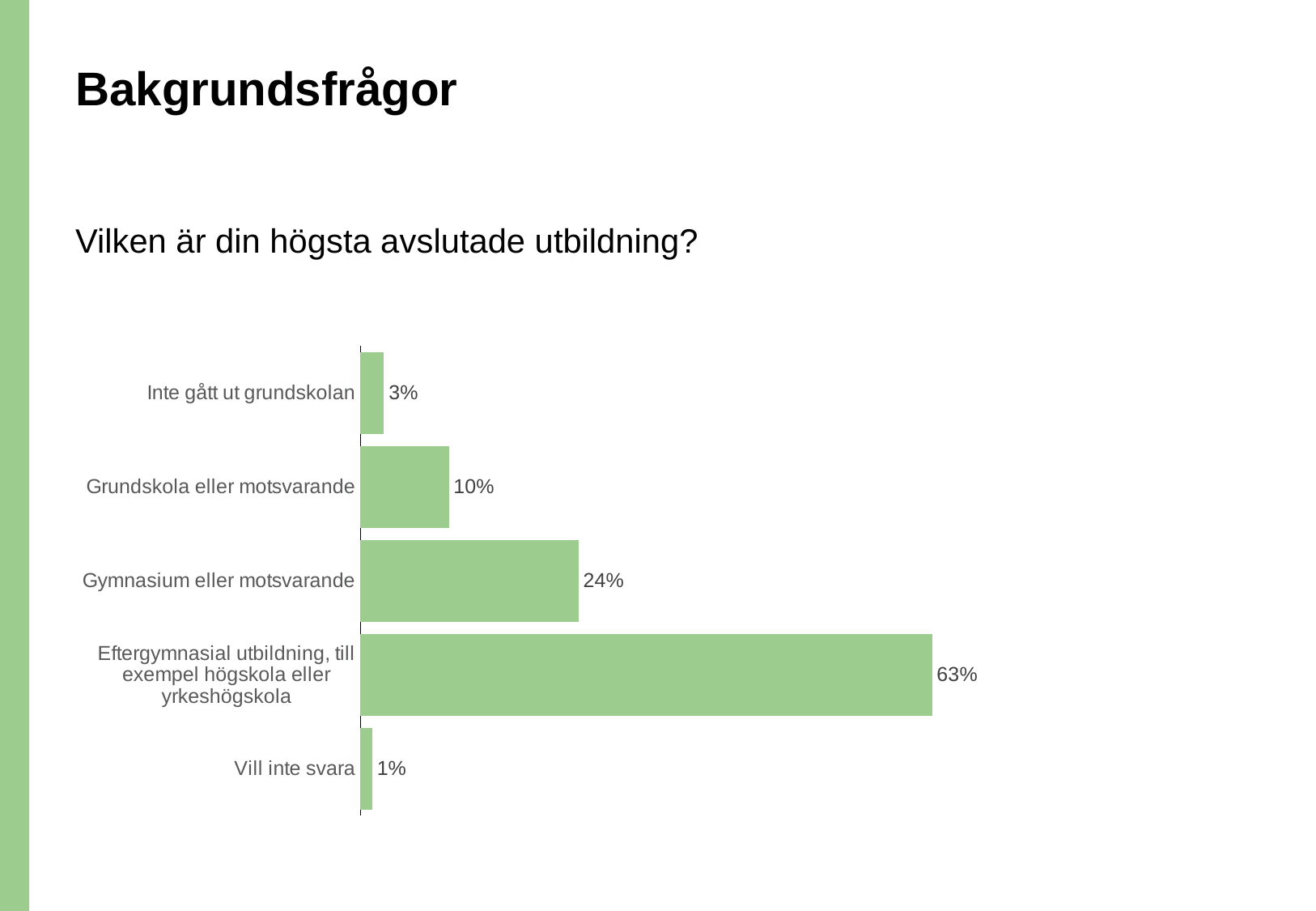
What is the value for "Grundskola eller motsvarande"? 10% What colour are the bars in the chart? Green Which category has the lowest value? Vill inte svara How many categories are shown in the chart? 5 What is the value for "Inte gått ut grundskolan"? 3% What kind of chart is shown on the slide? Bar chart Which category has the highest value? Eftergymnasial utbildning, till exempel högskola eller yrkeshögskola What is the value for "Gymnasium eller motsvarande"? 24% Which is larger, the value for "Grundskola eller motsvarande" or the value for "Inte gått ut grundskolan"? Grundskola eller motsvarande What question does the chart answer, as written above it? Vilken är din högsta avslutade utbildning? What is the value for "Vill inte svara"? 1% What is the difference between the values for "Eftergymnasial utbildning, till exempel högskola eller yrkeshögskola" and "Gymnasium eller motsvarande"? 39%